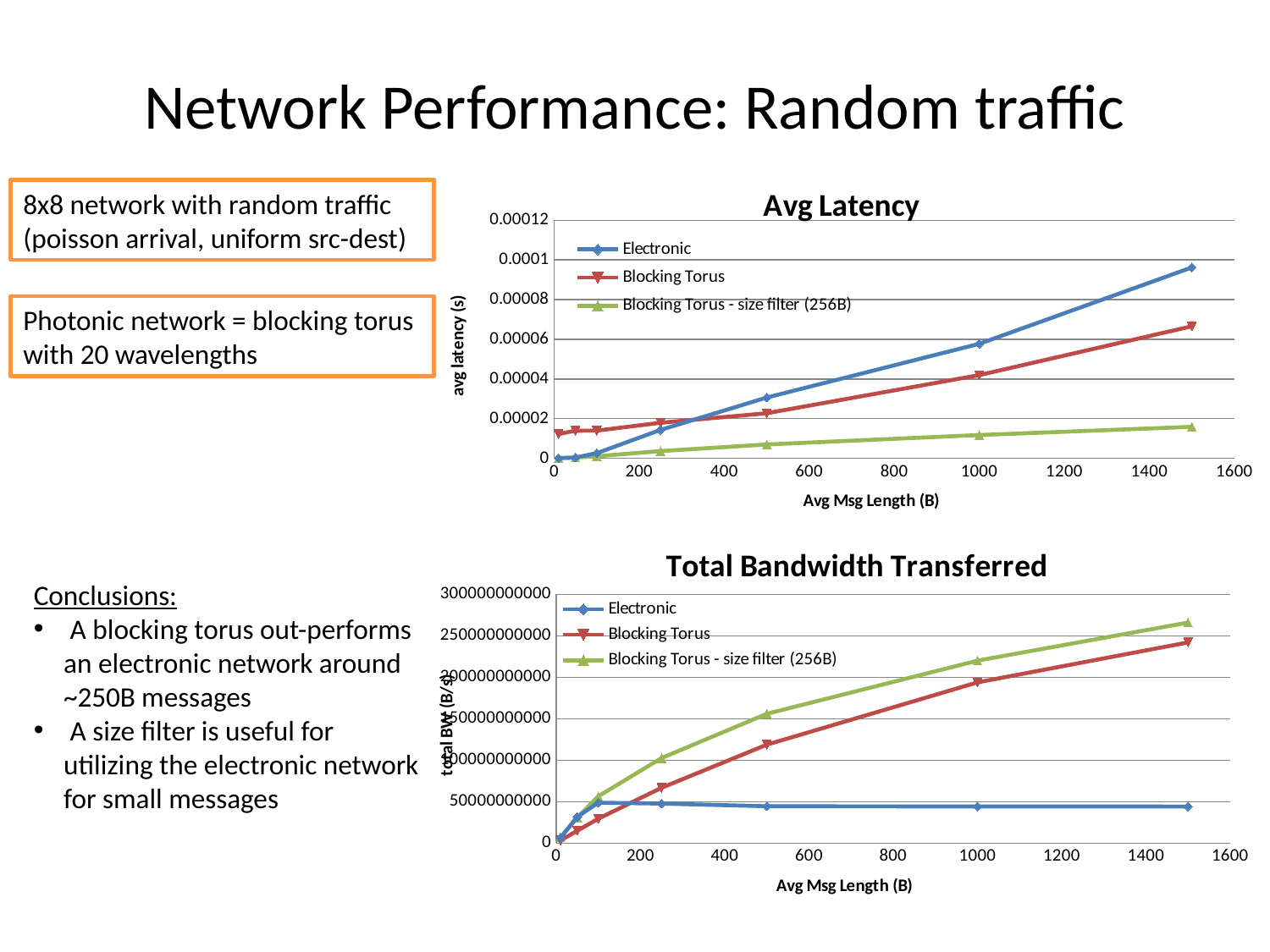
In the Total Bandwidth Transferred chart, at 1500 B, which is larger: Blocking Torus - size filter (256B) or Electronic? Blocking Torus - size filter (256B) In the Avg Latency chart, which series has the lowest latency at an average message length of 1500 B? Blocking Torus - size filter (256B) In the Avg Latency chart, is the Electronic value at 1500 B greater or less than 0.00008? greater What is the x-axis label of the Avg Latency chart? Avg Msg Length (B) What type of chart is the Avg Latency chart? line chart How many series does the legend of the Total Bandwidth Transferred chart list? 3 In the Total Bandwidth Transferred chart, which series has the lowest value at an average message length of 1500 B? Electronic In the Avg Latency chart, which series has the highest latency at an average message length of 1500 B? Electronic In the Avg Latency chart, is the Blocking Torus value at 1500 B greater or less than 0.00008? less In the Total Bandwidth Transferred chart, is the Electronic value at 1500 B greater or less than 50000000000? less In the Avg Latency chart, does the Electronic series rise or fall as average message length increases? rise